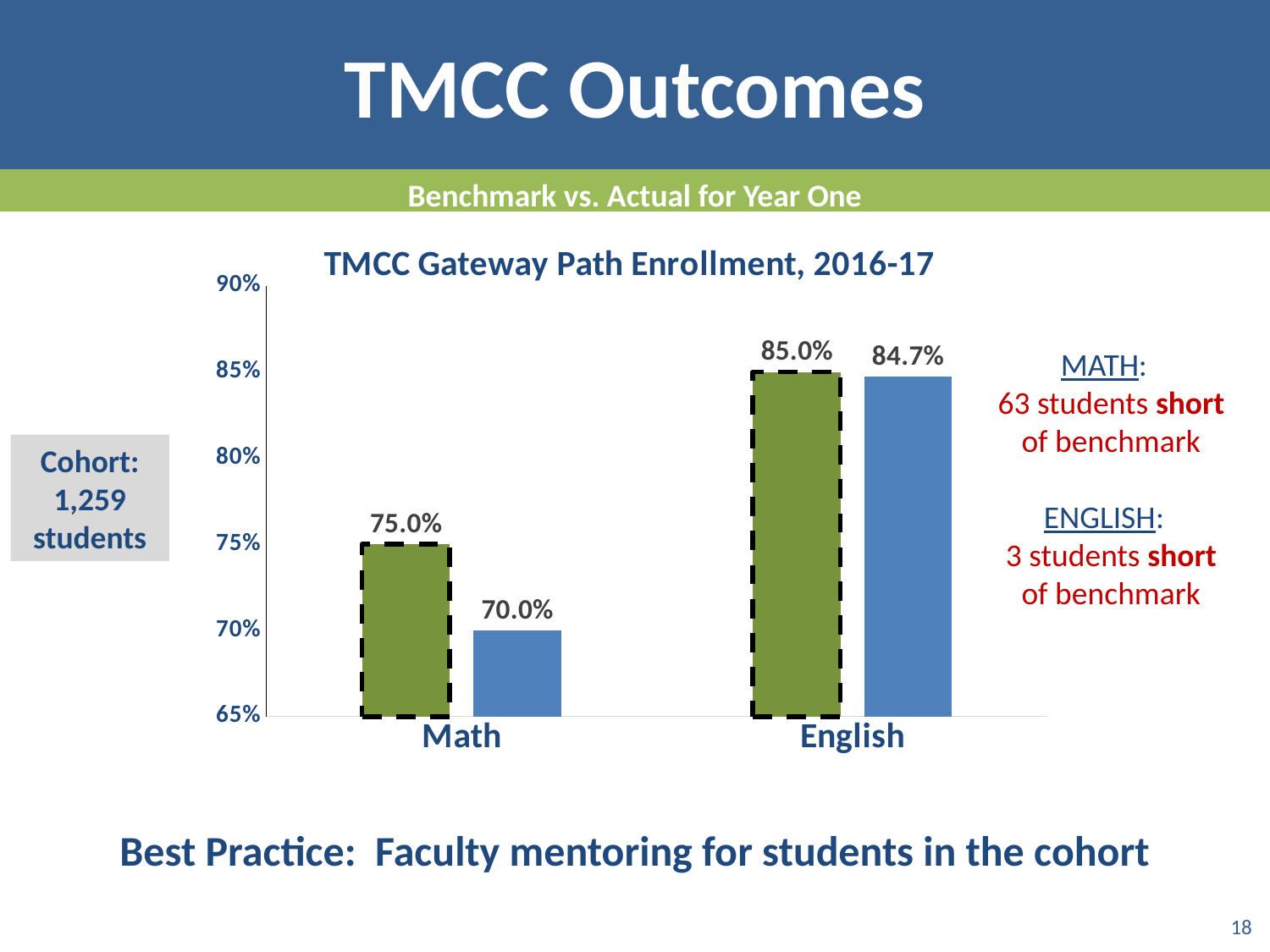
What is the value of the green (dashed-outline) bar for Math? 75.0% What is the value of the blue bar for English? 84.7% What type of chart is shown on the slide? bar chart What is the difference between the green bar and the blue bar for Math? 5.0% Is the value of the blue bar for English greater or less than 80%? greater Which category has the highest bar in the chart? English What is the value of the blue bar for Math? 70.0% What is the chart's title? TMCC Gateway Path Enrollment, 2016-17 Is the blue bar for Math larger or smaller than the blue bar for English? smaller How many categories are shown on the x axis of the chart? 2 What is the value of the green (dashed-outline) bar for English? 85.0% Which bar is the lowest in the chart? the blue bar for Math (70.0%)